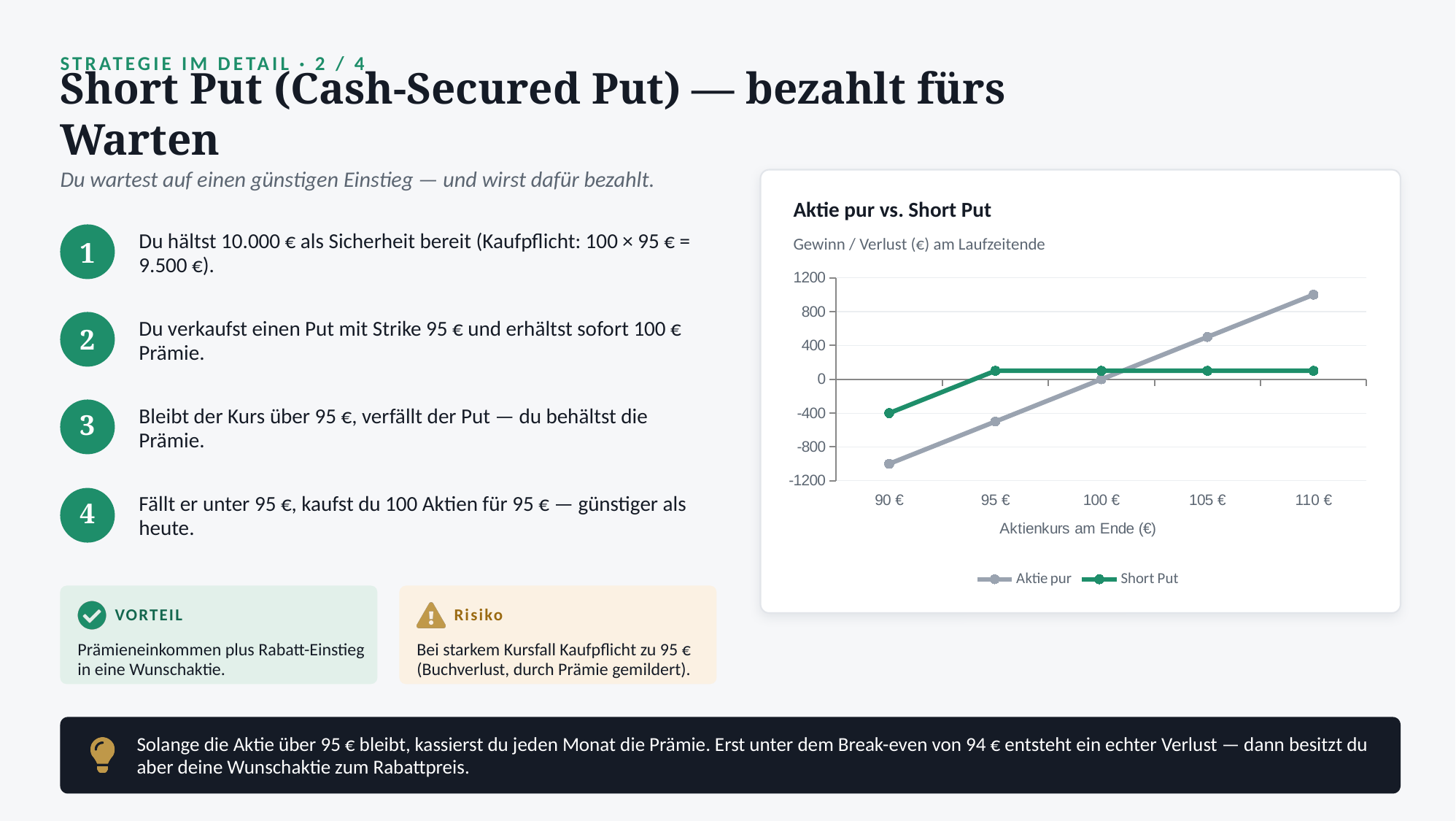
Is the value for Aktie pur at 90 € greater or less than -800? less Is the value for Aktie pur at 110 € greater or less than 800? greater How many stock price points are plotted along the x axis? 5 What is the value of the Short Put series at 90 €? -400 What is the value of the Aktie pur series at 100 €? 0 How many series does the chart legend list? 2 What kind of chart is shown on the slide? line chart At 110 €, which series has the higher value, Aktie pur or Short Put? Aktie pur Does the Aktie pur series rise or fall as the stock price increases along the x axis? rise At 90 €, which series has the higher value, Aktie pur or Short Put? Short Put What is the title of the chart? Aktie pur vs. Short Put Is the value for Aktie pur at 105 € greater or less than 400? greater